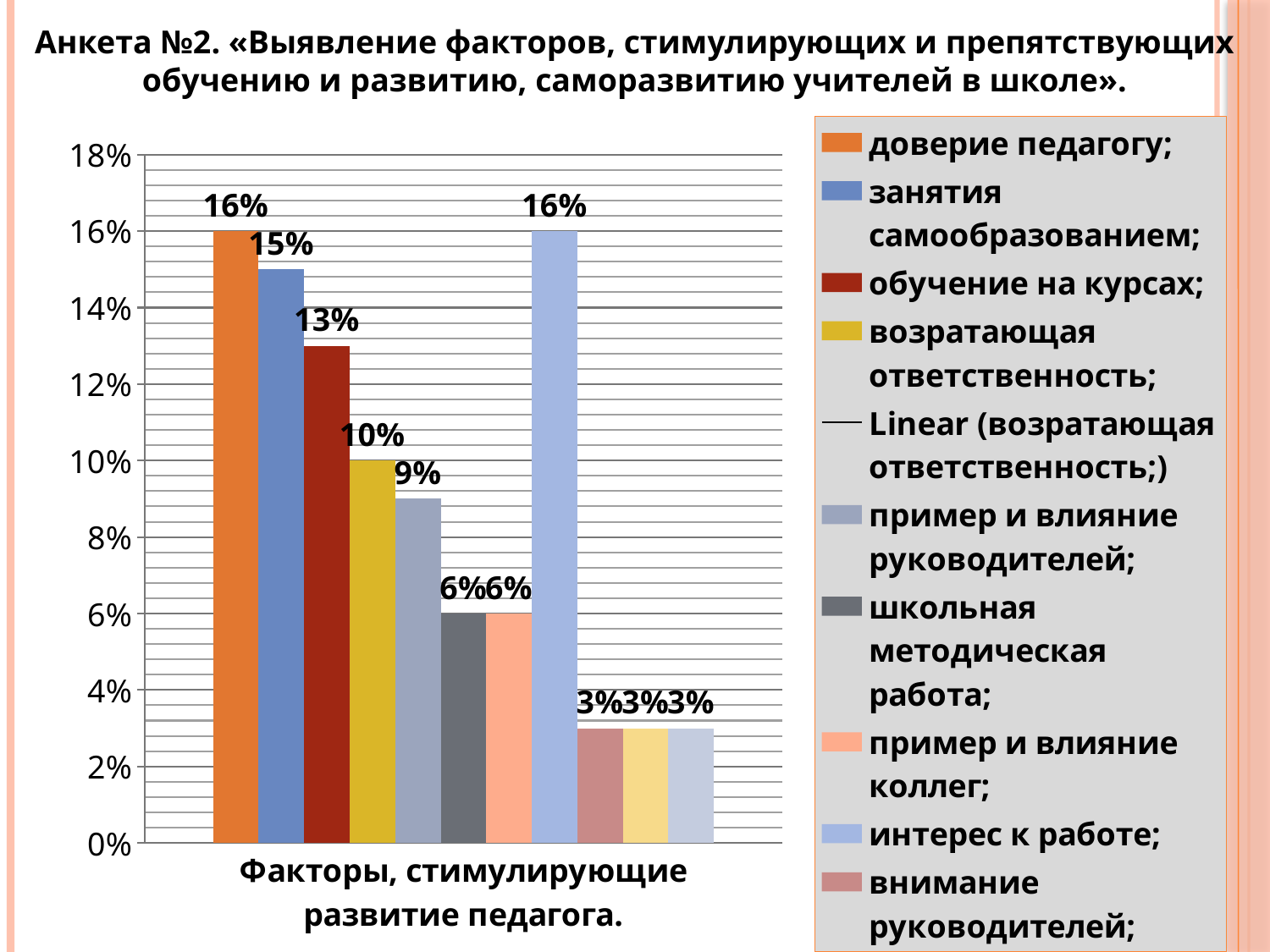
What is the difference between the values for «доверие педагогу» and «обучение на курсах»? 3% What is the value for «пример и влияние руководителей»? 9% What is the value for «занятия самообразованием»? 15% Is the value for «школьная методическая работа» greater or less than 8%? less What is the value for «внимание руководителей»? 3% Which is larger, the value for «занятия самообразованием» or the value for «обучение на курсах»? занятия самообразованием What is the value for «доверие педагогу»? 16% What is the value for «обучение на курсах»? 13% What is the value for «возратающая ответственность»? 10% What kind of chart is shown on the slide? bar chart What is the category label shown under the bars on the x axis? Факторы, стимулирующие развитие педагога. What is the value for «интерес к работе»? 16%